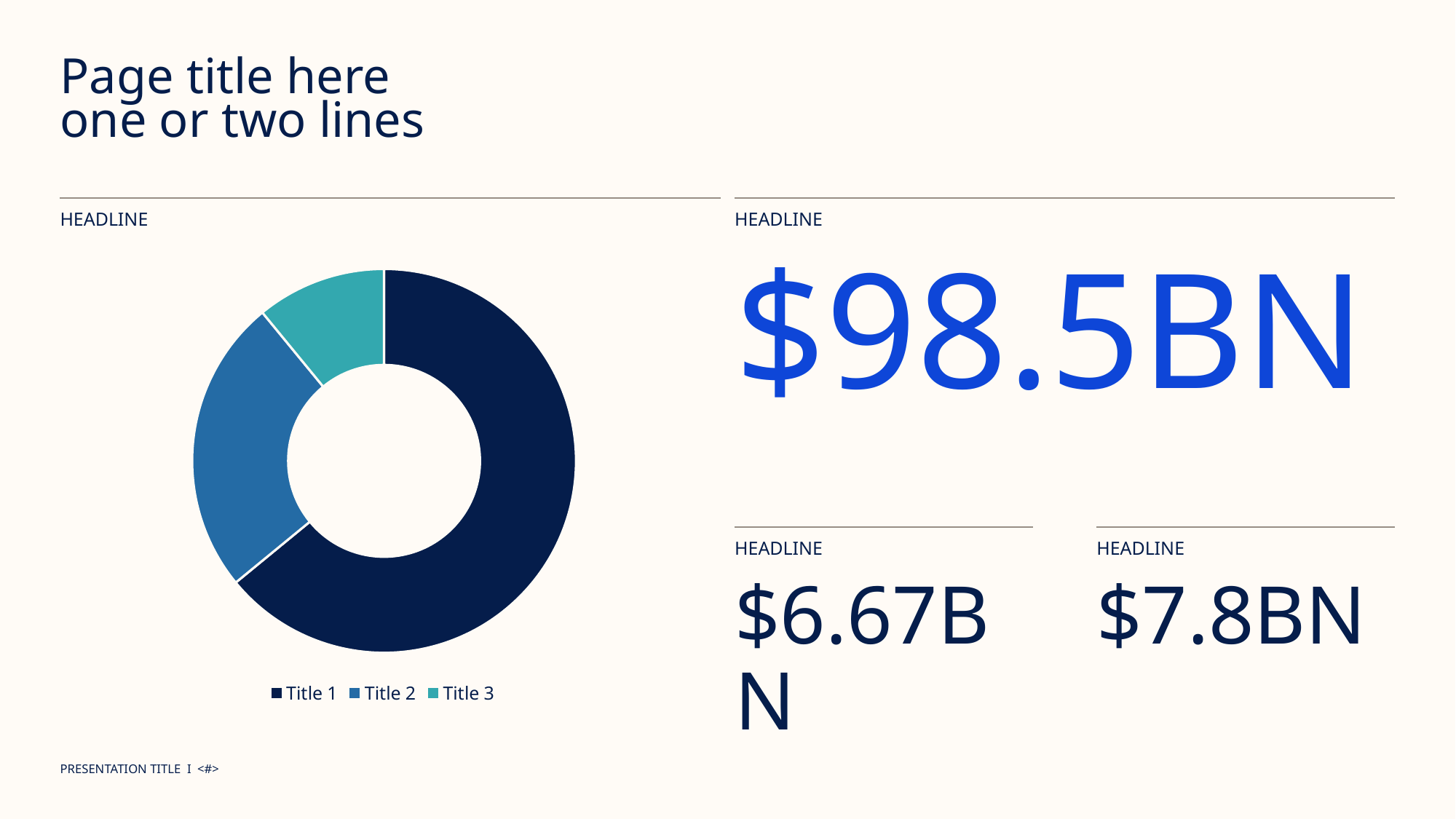
Which slice is smaller in the doughnut chart, Title 1 or Title 3? Title 3 Which category has the smallest slice in the doughnut chart? Title 3 Which category has the largest slice in the doughnut chart? Title 1 What kind of chart is shown on the slide? doughnut chart How many entries does the legend of the doughnut chart list? 3 Which slice is larger in the doughnut chart, Title 2 or Title 3? Title 2 What are the legend entries of the doughnut chart, in order? Title 1, Title 2, Title 3 How many slices does the doughnut chart have? 3 What colour is the Title 3 slice in the doughnut chart? teal Which slice is larger in the doughnut chart, Title 1 or Title 2? Title 1